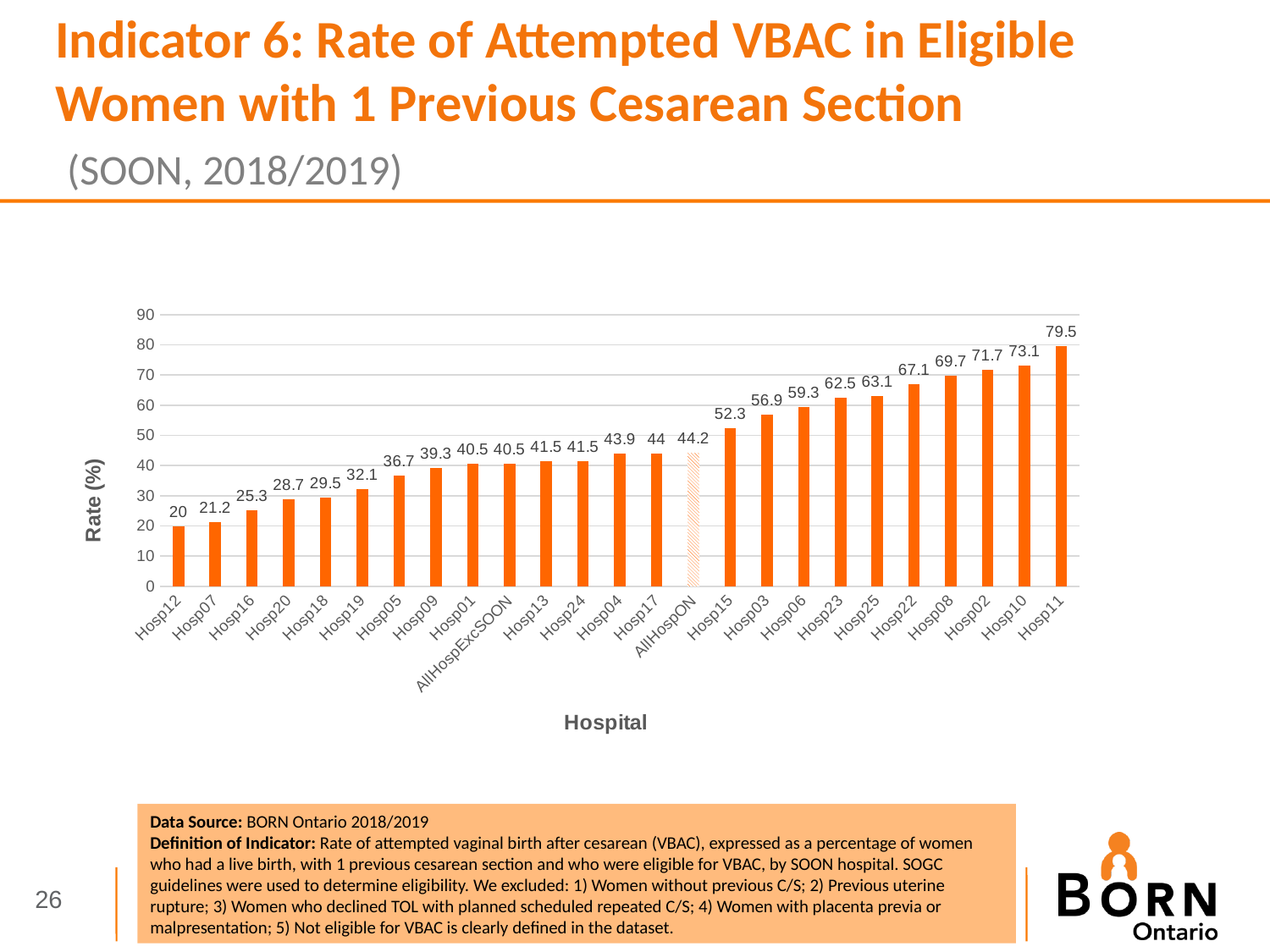
What is the rate for AllHospON? 44.2 Which hospital has the highest rate? Hosp11 Is the value for Hosp22 greater or less than 60? greater What is the rate for Hosp05? 36.7 What kind of chart is shown on the slide? Bar chart Which hospital has the lowest rate? Hosp12 Which has a higher rate, Hosp15 or Hosp17? Hosp15 What is the difference between the rates for AllHospON and AllHospExcSOON? 3.7 What is the difference between the rates for Hosp11 and Hosp12? 59.5 How many bars are shown on the chart? 25 Do the values rise or fall from left to right along the x axis? Rise What is the rate for Hosp11? 79.5